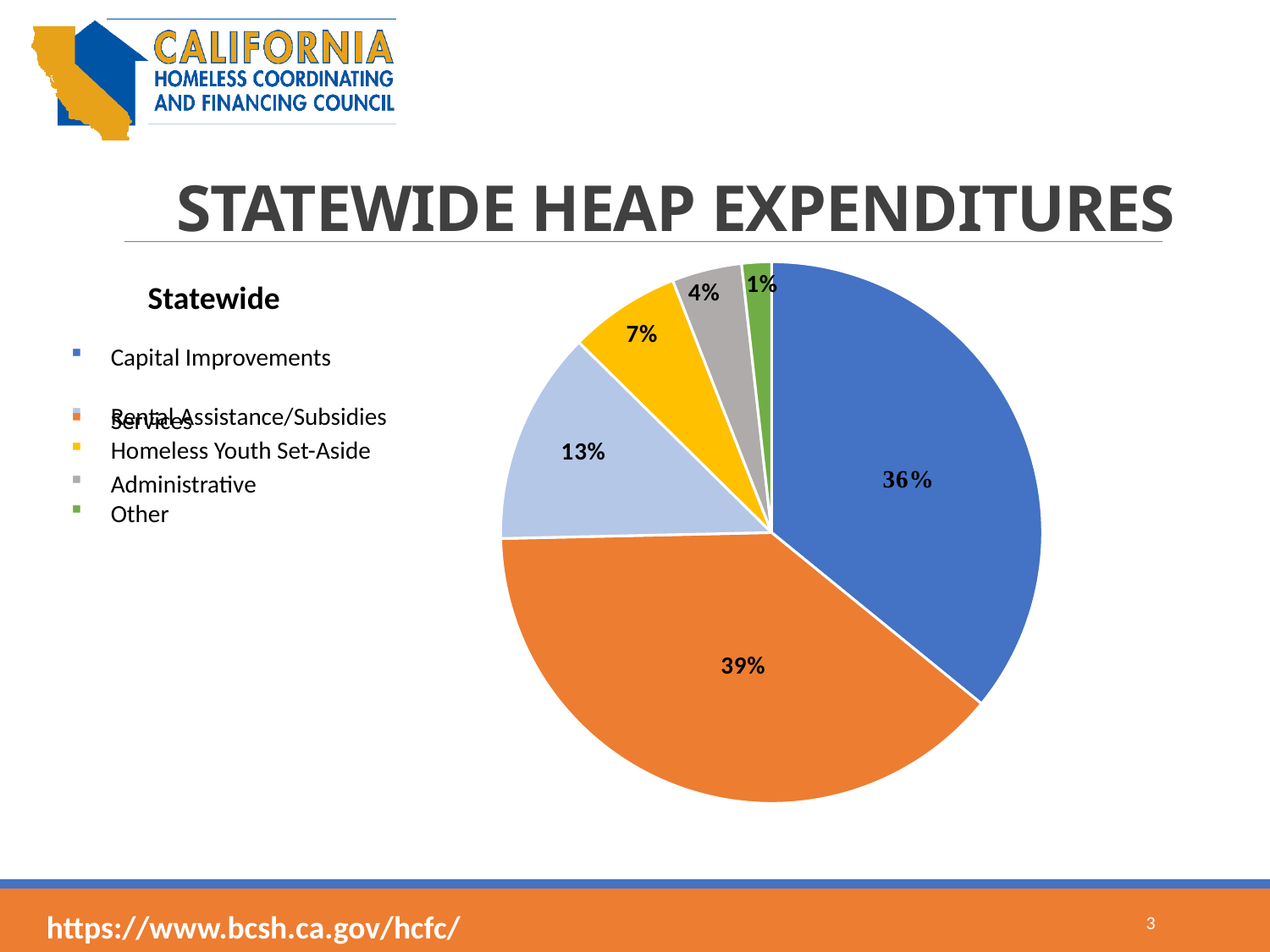
Which has a larger share, Capital Improvements or Administrative? Capital Improvements What is the difference in percentage points between Capital Improvements and Homeless Youth Set-Aside? 29 What percentage of statewide HEAP expenditures is shown for Homeless Youth Set-Aside? 7% What percentage of statewide HEAP expenditures is shown for Administrative? 4% What percentage of statewide HEAP expenditures is shown for Capital Improvements? 36% Which category has the smallest share of the pie chart? Other How many slices does the pie chart have? 6 What is the title of the slide containing the pie chart? STATEWIDE HEAP EXPENDITURES How many entries does the chart legend list? 6 What percentage of statewide HEAP expenditures is shown for Other? 1% What is the largest percentage labelled on the pie chart? 39% What kind of chart is shown on the slide? pie chart